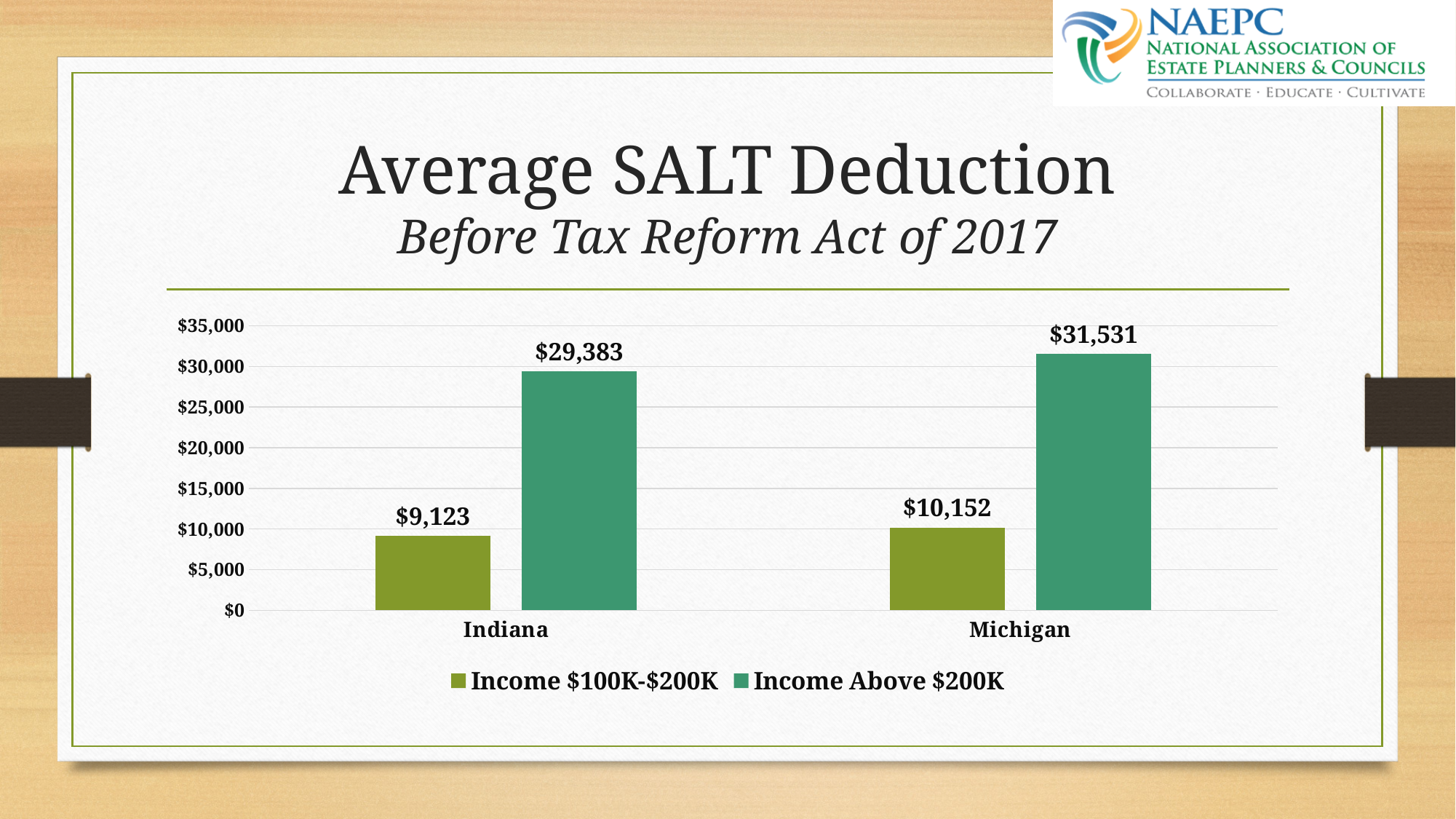
What is the difference between Michigan and Indiana for Income Above $200K? $2,148 What kind of chart is shown on the slide? Bar chart What is the average SALT deduction for Michigan for Income Above $200K? $31,531 How many states are shown on the x axis? 2 What is the average SALT deduction for Michigan for Income $100K-$200K? $10,152 What is the average SALT deduction for Indiana for Income Above $200K? $29,383 What is the difference between the Income Above $200K and Income $100K-$200K values for Indiana? $20,260 What is the average SALT deduction for Indiana for Income $100K-$200K? $9,123 How many series does the legend list? 2 Is the Income $100K-$200K value for Michigan larger than the Income $100K-$200K value for Indiana? Yes Which bar on the chart shows the lowest value? Indiana, Income $100K-$200K Which state has the higher average SALT deduction for Income Above $200K? Michigan